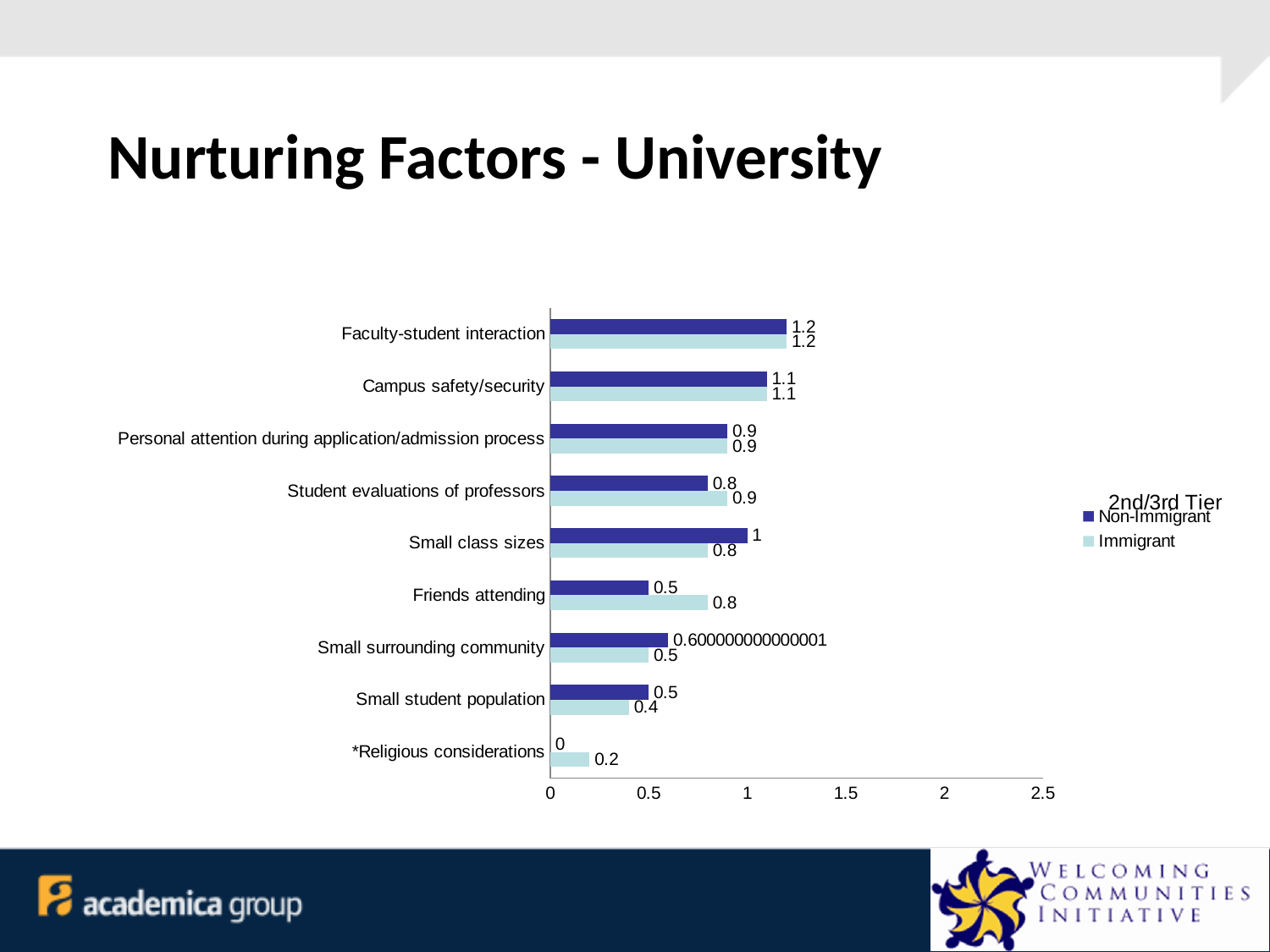
What kind of chart is shown on the slide? bar chart How many categories are plotted on the chart? 9 How many series does the legend list? 2 What title appears above the legend entries? 2nd/3rd Tier What is the difference between the Immigrant and Non-Immigrant values for Friends attending? 0.3 What is the Non-Immigrant value for Campus safety/security? 1.1 What is the Non-Immigrant value for Small class sizes? 1 Which category has the highest Non-Immigrant value? Faculty-student interaction What is the Immigrant value for Friends attending? 0.8 What is the Immigrant value for *Religious considerations? 0.2 For Small student population, which series has the larger value, Non-Immigrant or Immigrant? Non-Immigrant Which category has the lowest Immigrant value? *Religious considerations